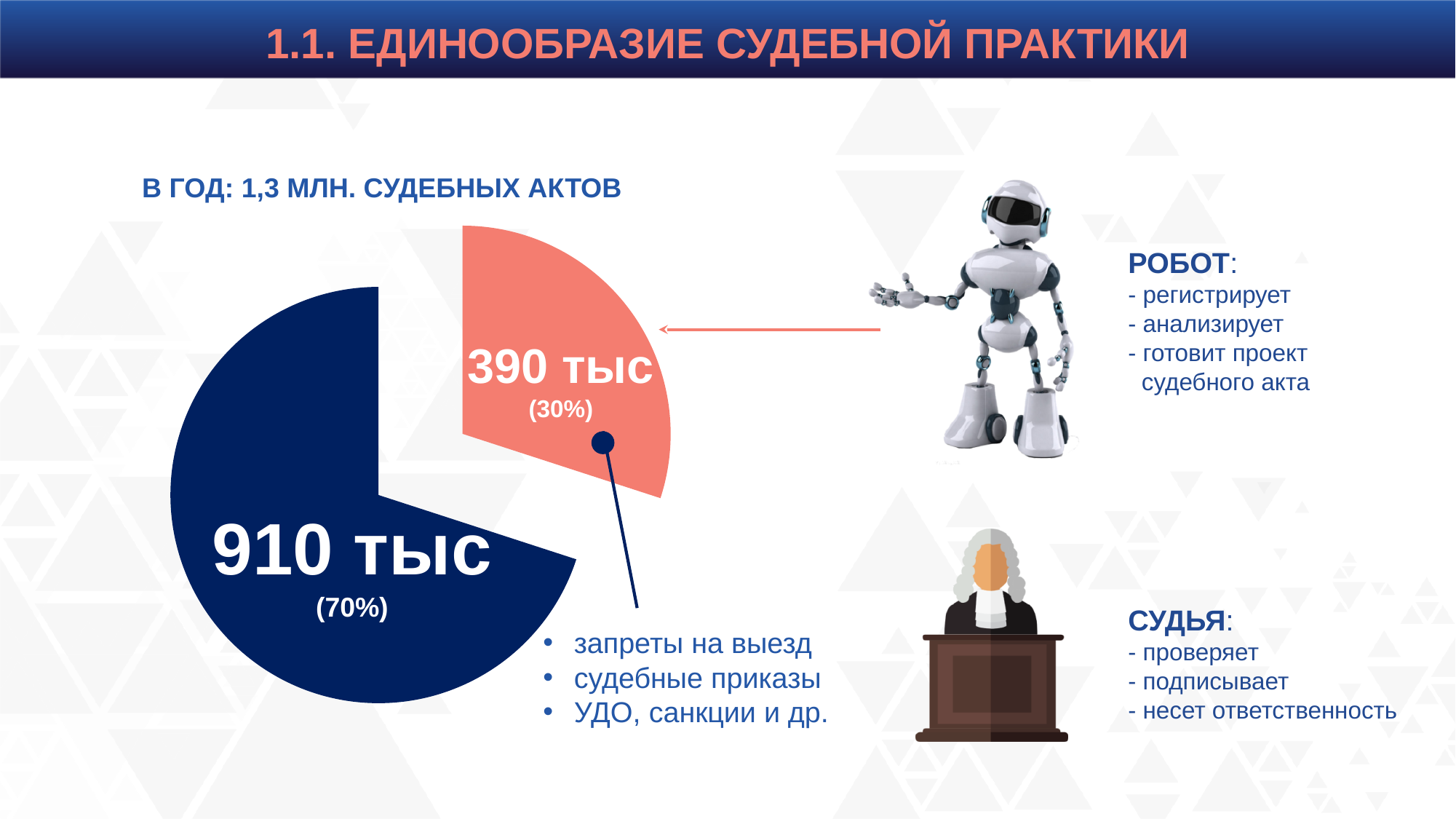
Which slice of the pie chart is the smallest? 390 тыс (30%) What share of the pie does the salmon-coloured slice represent? 30% What share of the pie does the dark blue slice represent? 70% How many slices does the pie chart have? 2 Which is larger: the dark blue slice or the salmon-coloured slice? the dark blue slice What value is printed on the dark blue slice of the pie chart? 910 тыс What is the heading printed above the pie chart? В ГОД: 1,3 МЛН. СУДЕБНЫХ АКТОВ What is the difference between the two slice values in the pie chart? 520 тыс What total number of judicial acts per year is stated above the pie chart? 1,3 млн. Which slice of the pie chart is the largest? 910 тыс (70%) What value is printed on the salmon-coloured slice of the pie chart? 390 тыс What kind of chart is shown on the slide? pie chart